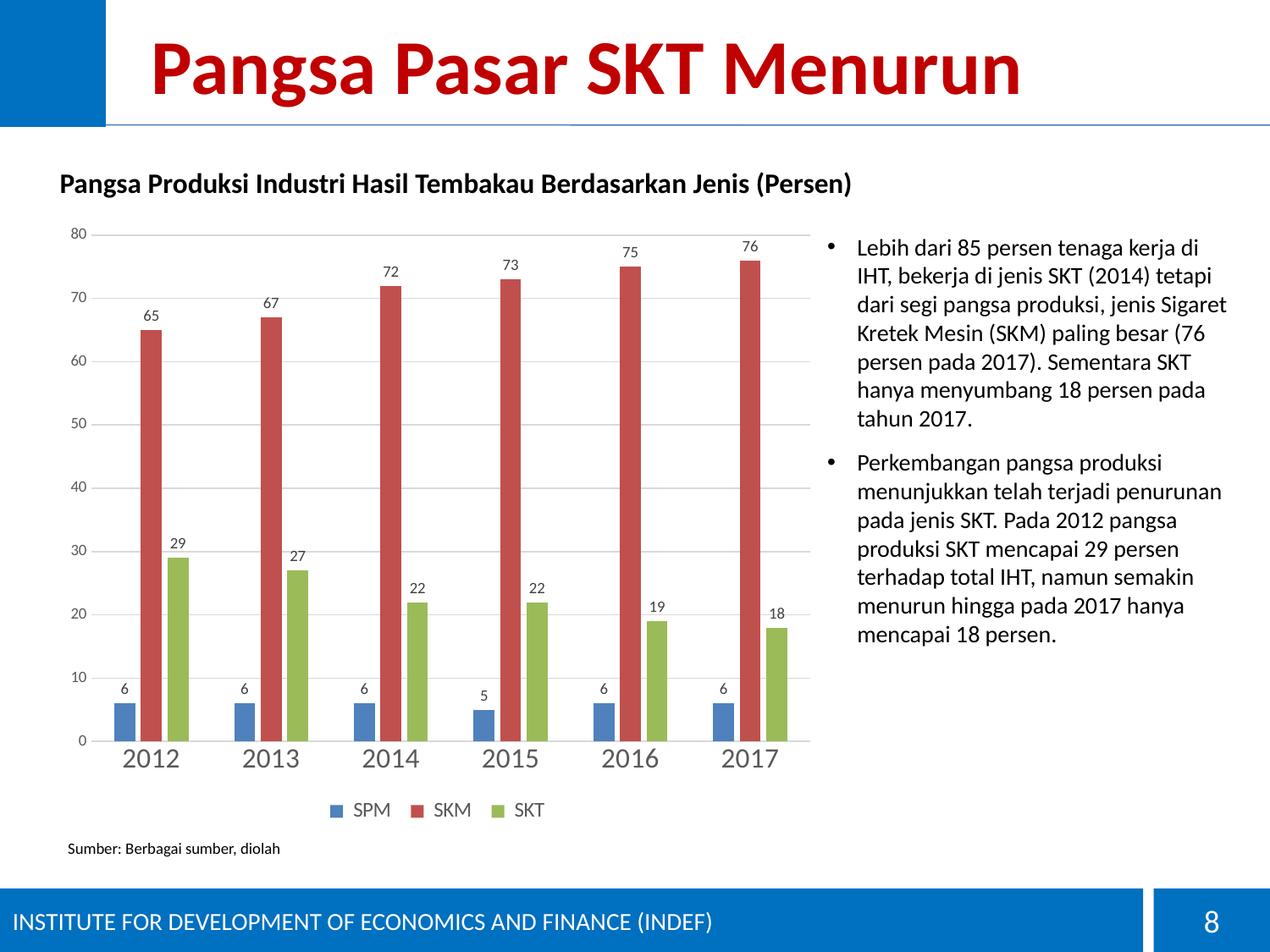
Does the SKT value rise or fall from 2012 to 2017? fall What is the SKT value for 2012? 29 Is the SKM value for 2013 greater or less than 60? greater Which is larger in 2014, the SKM value or the SKT value? SKM What is the SKM value for 2017? 76 What kind of chart is shown on the slide? bar chart In which year is the SKM value highest? 2017 How many years are shown on the x axis? 6 What is the difference between the SKT values for 2012 and 2017? 11 In which year is the SKT value lowest? 2017 What is the SPM value for 2015? 5 How many series does the legend list? 3